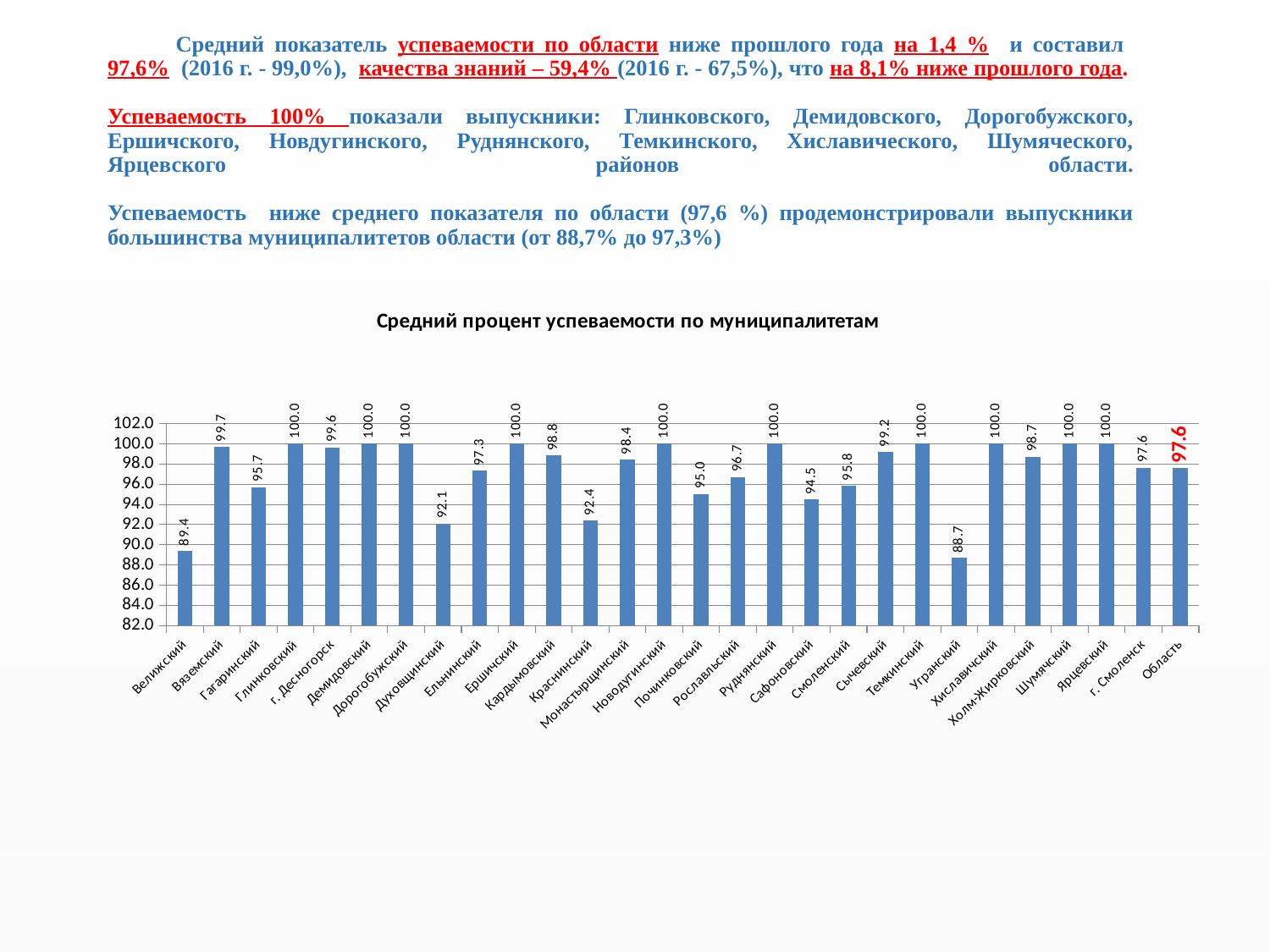
What is the difference between the values for Вяземский and Велижский? 10.3 How many bars (categories) are shown in the chart? 28 What kind of chart is shown on the slide? bar chart What is the value for Угранский in the chart? 88.7 What is the value for Велижский in the chart? 89.4 What is the title of the chart? Средний процент успеваемости по муниципалитетам What is the value shown for Область (the last bar)? 97.6 Which municipality has the lowest value in the chart? Угранский Which has a larger value, Духовщинский or Краснинский? Краснинский Is the value for Сафоновский greater or less than 96.0? less What is the value for Холм-Жирковский? 98.7 What is the difference between the value for Область and the value for Угранский? 8.9